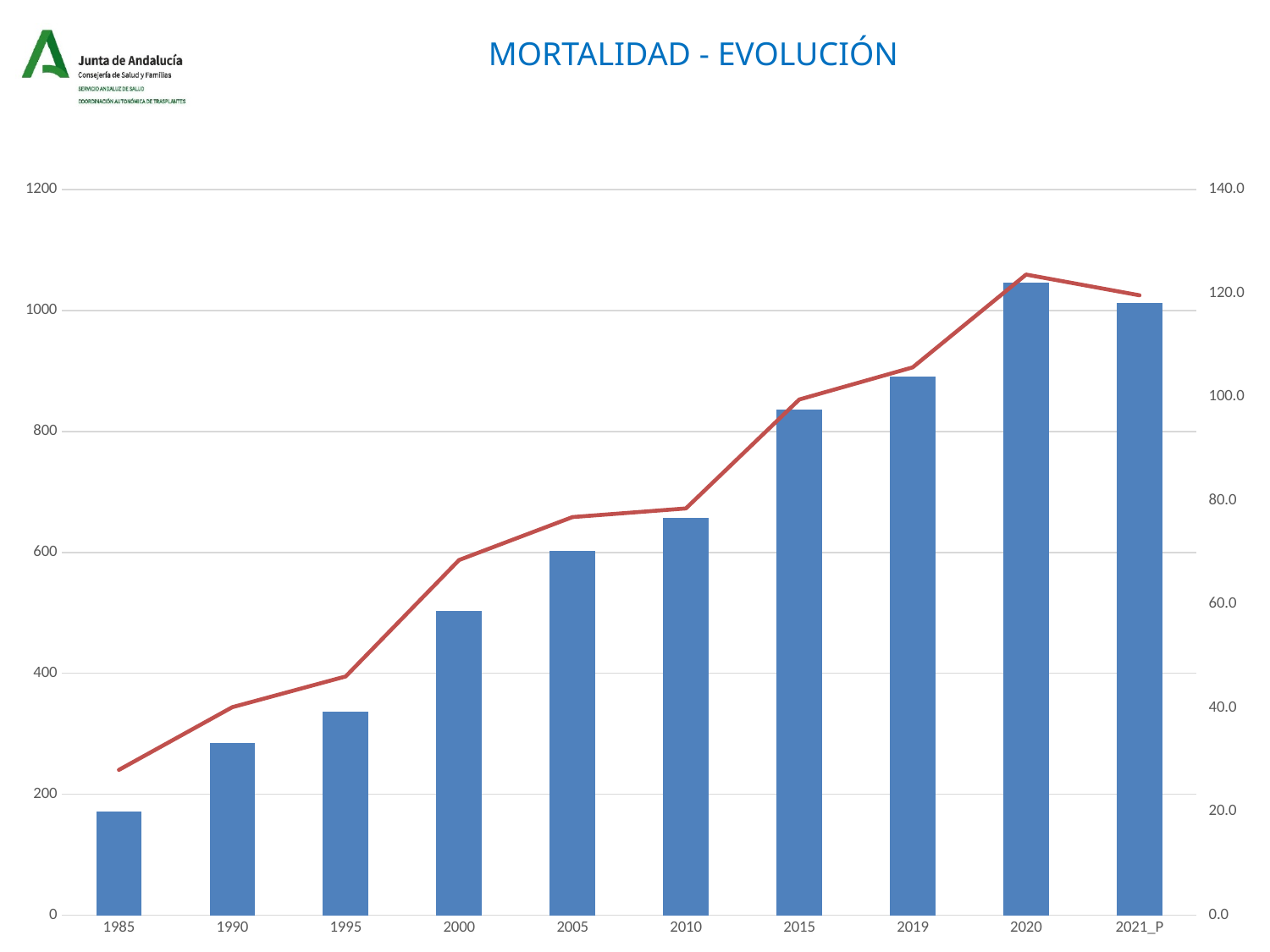
What is the title of the chart on the slide? MORTALIDAD - EVOLUCIÓN Do the bar values generally rise or fall from 1985 to 2020? Rise Is the bar value for 1985 greater or less than 200? less Which year has the tallest bar in the chart? 2020 Is the bar value for 2020 greater or less than 1000? greater Is the bar value for 2010 greater or less than 800? less Which year has the shortest bar in the chart? 1985 How many years are shown along the x axis of the chart? 10 Which bar is taller, 2020 or 2021_P? 2020 Which bar is taller, 1990 or 1995? 1995 What kind of chart is shown on the slide? A combined bar and line chart